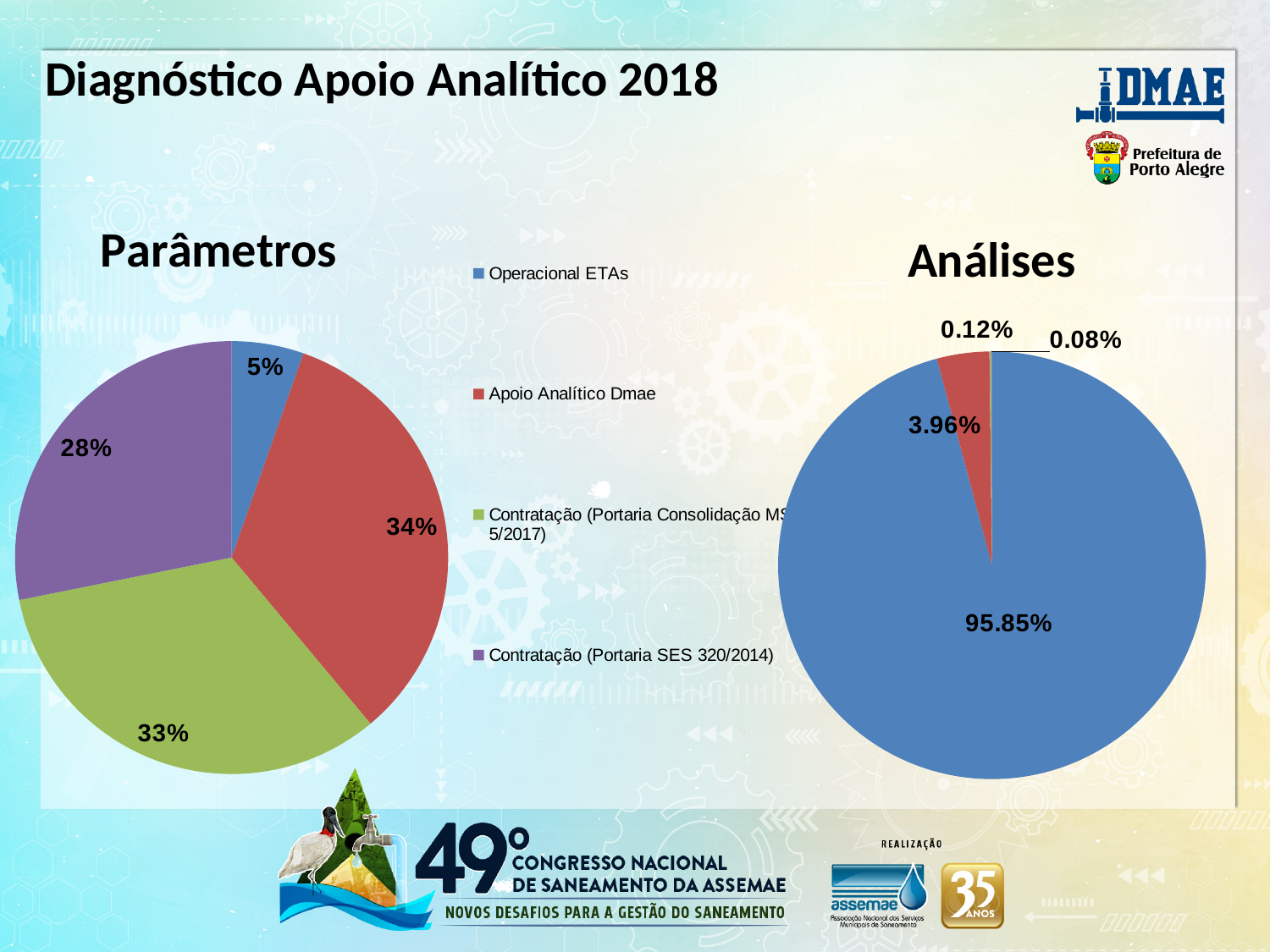
In the Parâmetros pie chart, what share is labelled for Operacional ETAs? 5% In the Parâmetros pie chart, what is the difference between the Apoio Analítico Dmae share and the Operacional ETAs share? 29% In the Parâmetros pie chart, what share is labelled for Contratação (Portaria SES 320/2014)? 28% In the Parâmetros pie chart, which category has the smallest slice? Operacional ETAs In the Análises pie chart, which category has the largest slice? Operacional ETAs In the Parâmetros pie chart, what share is labelled for Apoio Analítico Dmae? 34% How many entries does the legend list? 4 In the Análises pie chart, what is the smallest percentage labelled? 0.08% What kind of chart is the Análises chart? Pie chart In the Parâmetros pie chart, what share is labelled for Contratação (Portaria Consolidação MS 5/2017)? 33% In the Análises pie chart, what share is labelled for Operacional ETAs? 95.85% In the Análises pie chart, what share is labelled for Apoio Analítico Dmae? 3.96%